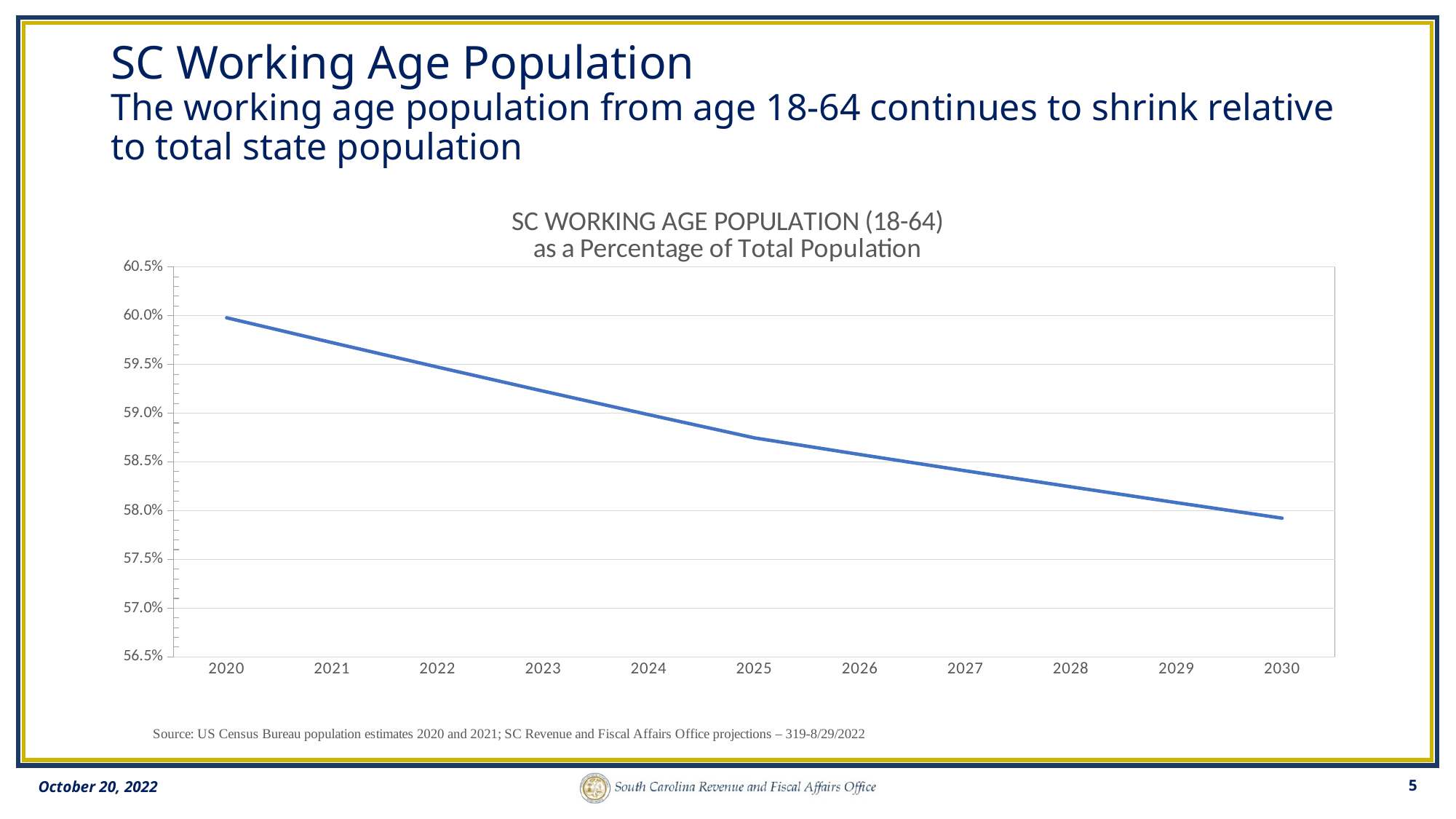
Does the working age population percentage rise or fall from 2020 to 2030? Fall Which year has the lowest working age population percentage? 2030 Is the value for 2025 greater or less than 59.0%? less What kind of chart is shown on the slide? Line chart Is the value for 2028 greater or less than 58.0%? greater How many years are plotted along the x axis of the chart? 11 Is the value for 2020 greater or less than 59.5%? greater Which year has a larger working age population percentage, 2022 or 2027? 2022 What is the title of the chart? SC WORKING AGE POPULATION (18-64) as a Percentage of Total Population Which year has the highest working age population percentage? 2020 What is the lowest value labelled on the y axis of the chart? 56.5%